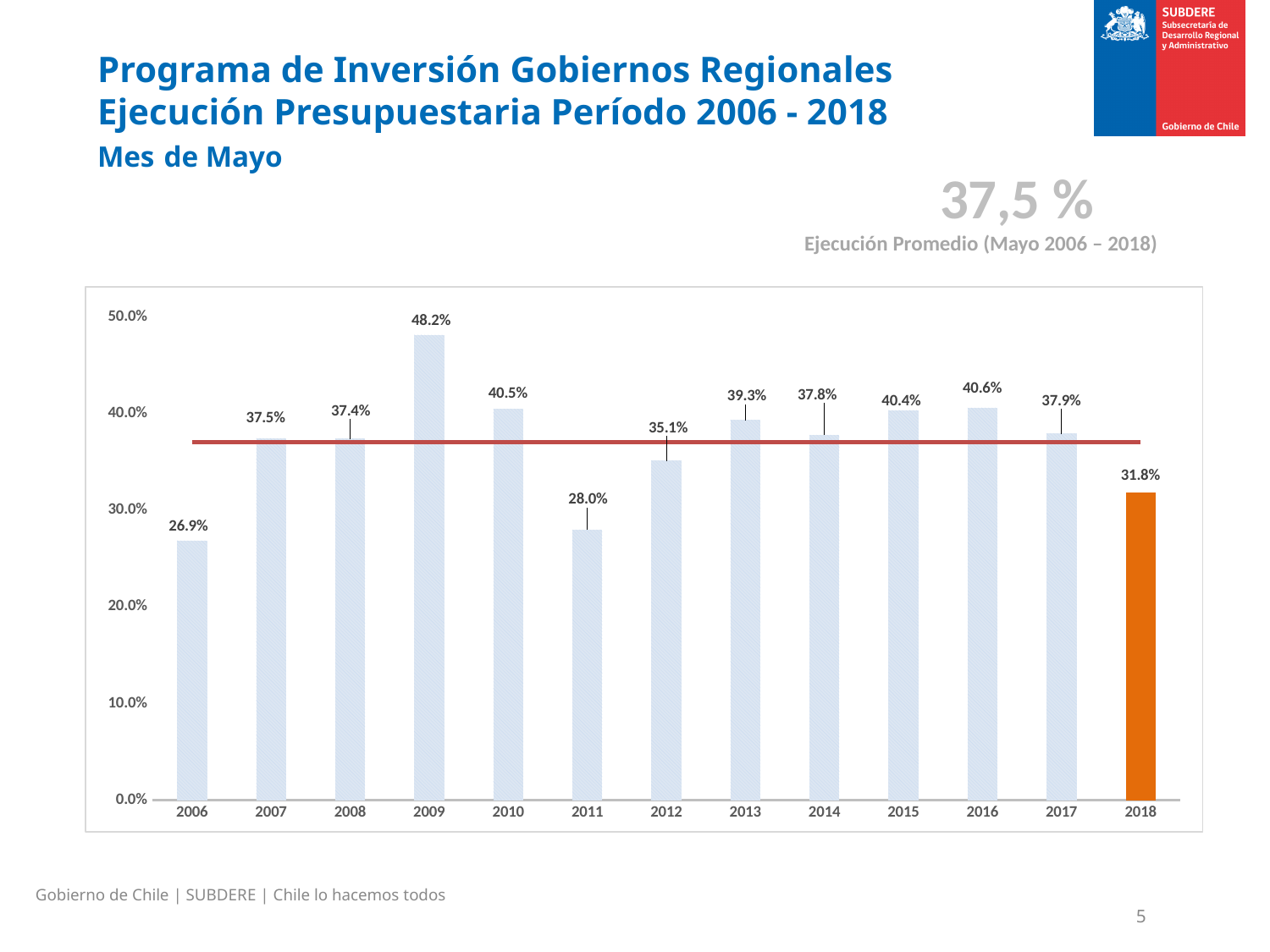
Is the value for 2016 greater or less than 40.0%? greater Which is larger, the value for 2010 or the value for 2012? 2010 Which year has the lowest value? 2006 Which year has the highest value? 2009 How many years are shown on the x axis? 13 What is the value for 2009? 48.2% What kind of chart is shown? bar chart What is the value for 2011? 28.0% What is the value for 2018? 31.8% What average execution value is shown above the chart? 37,5 % What is the difference between the values for 2009 and 2006? 21.3% Which year's bar is coloured orange? 2018